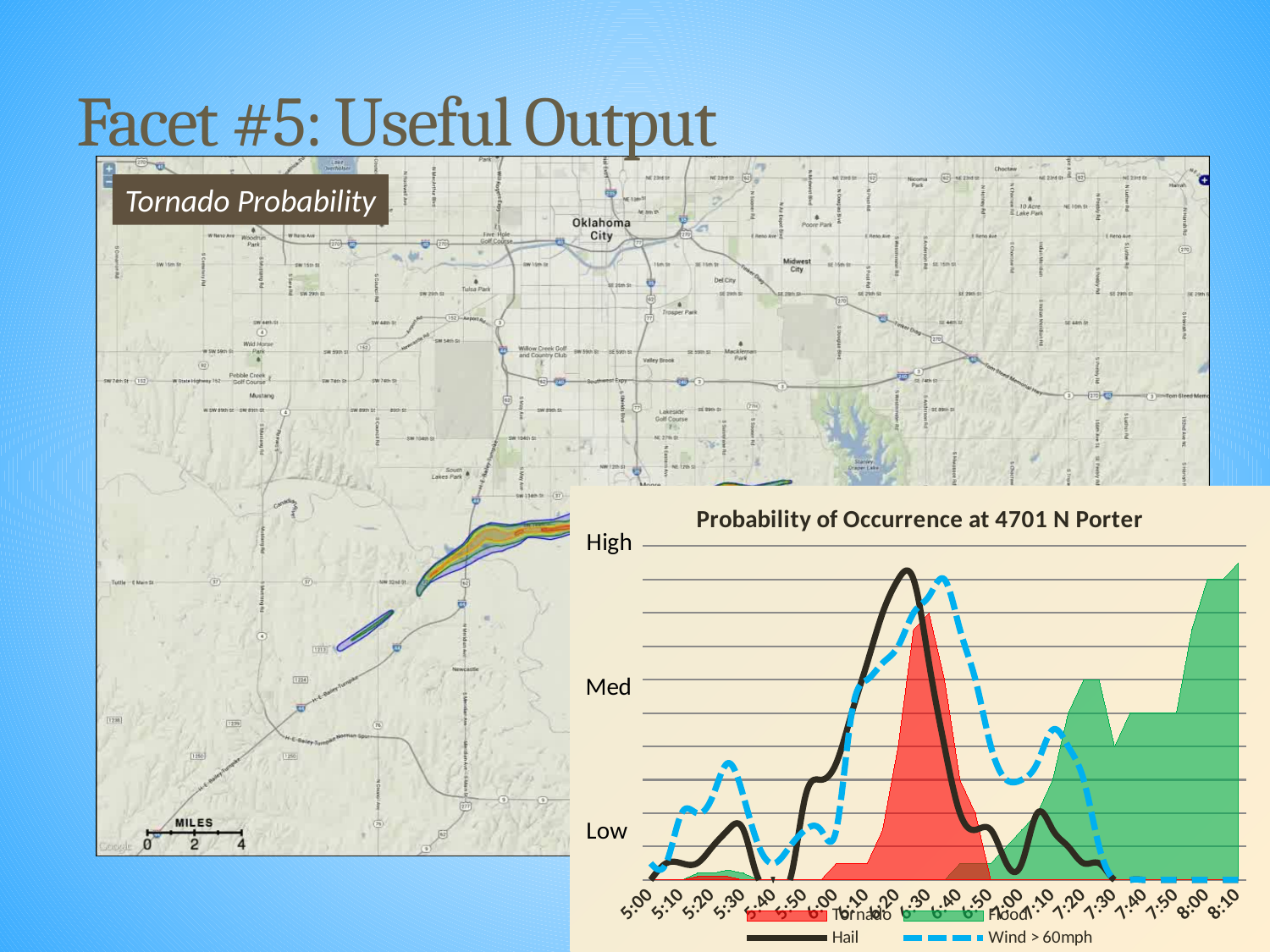
How many time points are labelled on the x axis of the chart? 20 At 8:00, which is higher on the chart: Flood or Tornado? Flood How many series does the chart's legend list? 4 At 5:30, which is higher on the chart: Wind > 60mph or Hail? Wind > 60mph What is the title of the chart on the slide? Probability of Occurrence at 4701 N Porter Which series reaches the highest probability anywhere on the chart? Flood At around what time does the Tornado probability reach its peak? 6:30 What kind of chart is the 'Probability of Occurrence at 4701 N Porter' chart? line and area chart Does the Tornado probability rise or fall between 6:30 and 7:00? fall At 6:30, which is higher on the chart: Hail or Tornado? Tornado Does the Flood probability rise or fall between 7:30 and 8:10? rise What is the full legend label for the blue dashed series in the chart? Wind > 60mph